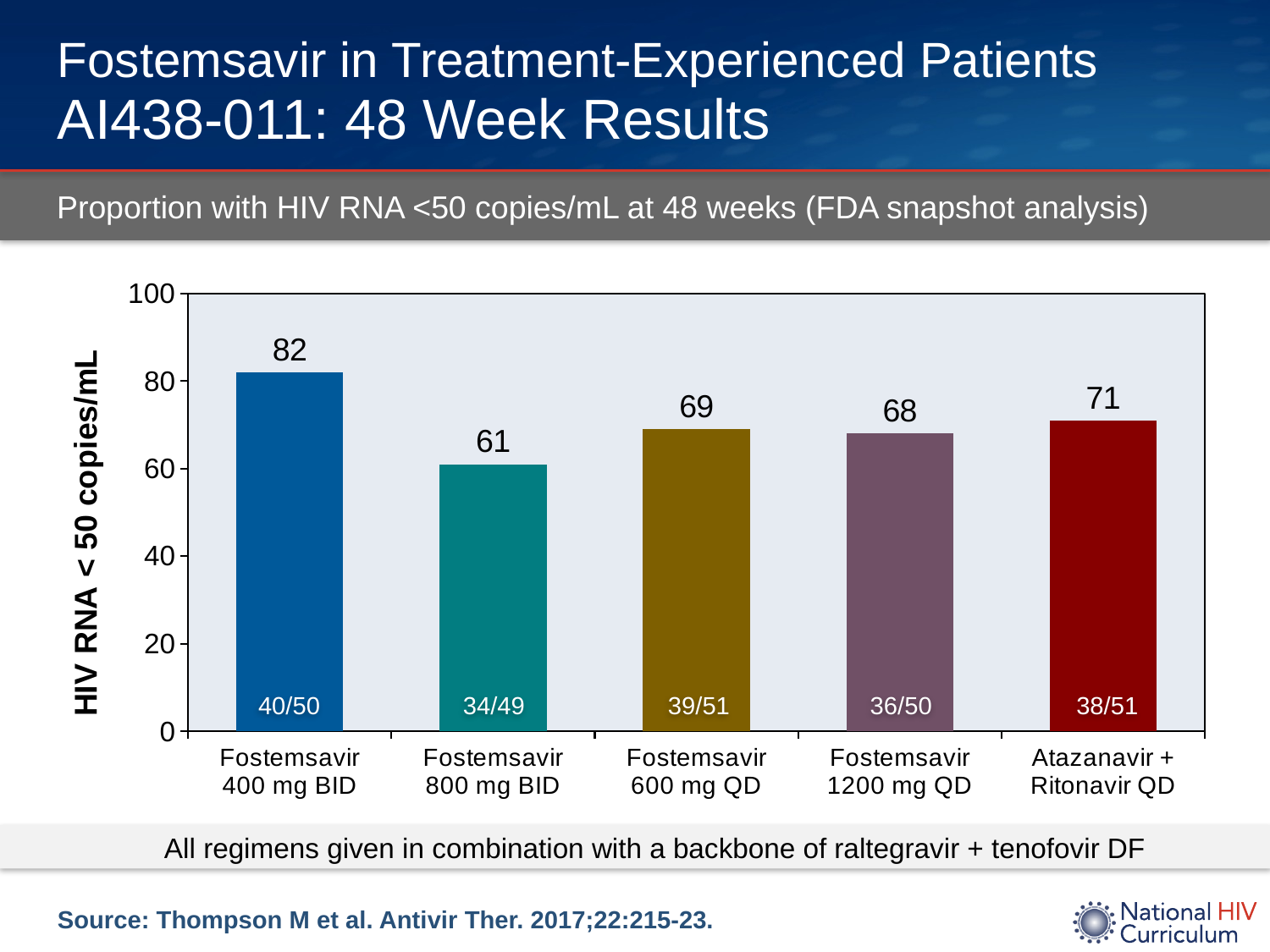
Is the value for Fostemsavir 1200 mg QD greater or less than 60? greater How many categories are shown on the x axis? 5 What fraction is printed inside the bar for Fostemsavir 600 mg QD? 39/51 What is the difference between the values for Atazanavir + Ritonavir QD and Fostemsavir 1200 mg QD? 3 What is the value for Fostemsavir 400 mg BID? 82 What kind of chart is shown on the slide? bar chart Which category has the highest value? Fostemsavir 400 mg BID What is the difference between the values for Fostemsavir 400 mg BID and Fostemsavir 800 mg BID? 21 Which is larger, the value for Fostemsavir 600 mg QD or Atazanavir + Ritonavir QD? Atazanavir + Ritonavir QD Which category has the lowest value? Fostemsavir 800 mg BID What is the value for Atazanavir + Ritonavir QD? 71 What is the value for Fostemsavir 800 mg BID? 61